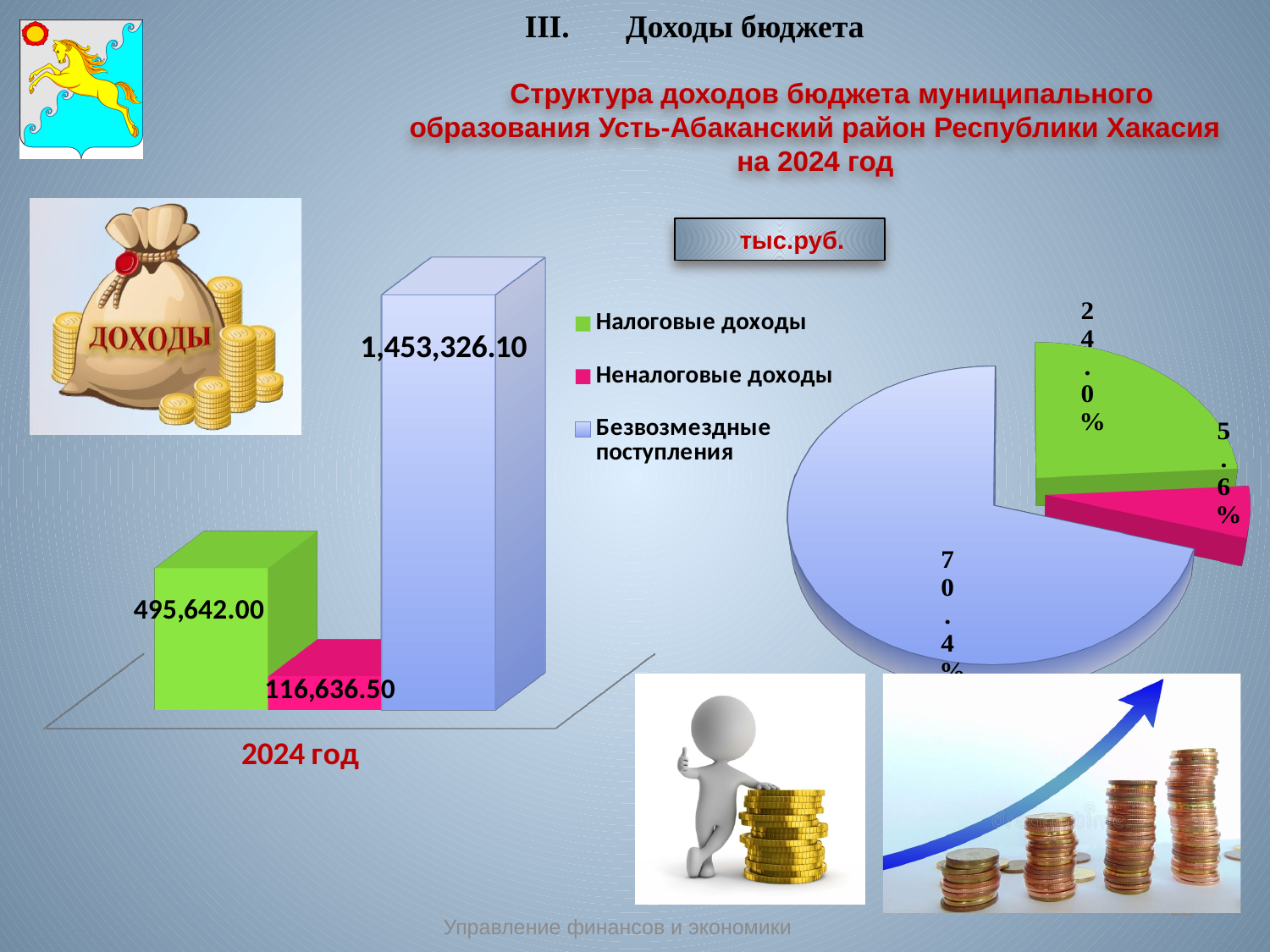
On the bar chart on the left, which is larger: Налоговые доходы or Безвозмездные поступления? Безвозмездные поступления On the pie chart on the right, what share does the blue slice (Безвозмездные поступления) have? 70.4% What kind of chart is the chart on the left? bar chart On the bar chart on the left, what is the value for Неналоговые доходы in 2024 год? 116,636.50 On the pie chart on the right, what share does the pink slice (Неналоговые доходы) have? 5.6% On the bar chart on the left, what is the value for Налоговые доходы in 2024 год? 495,642.00 On the bar chart on the left, which category has the lowest value? Неналоговые доходы On the bar chart on the left, what is the value for Безвозмездные поступления in 2024 год? 1,453,326.10 How many series does the legend list? 3 On the bar chart on the left, what is the difference between Налоговые доходы and Неналоговые доходы? 379,005.50 On the bar chart on the left, which category has the highest value? Безвозмездные поступления On the pie chart on the right, what share does the green slice (Налоговые доходы) have? 24.0%